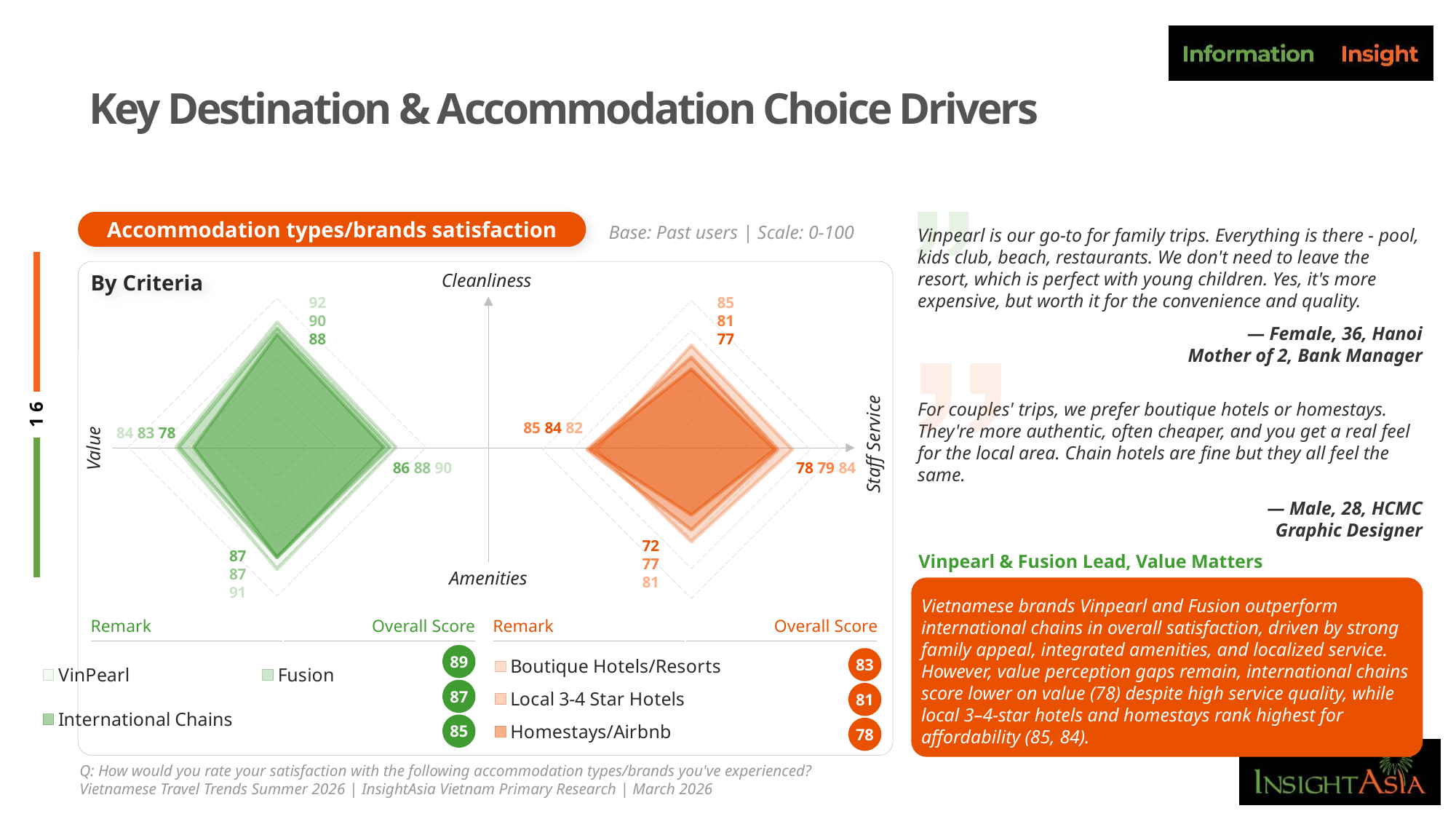
In the accommodation types chart (right, orange), what is the Overall Score for Homestays/Airbnb? 78 In the green brands chart, what is the Value score for International Chains? 78 How many criteria axes does each radar chart have? 4 What is the difference between the Overall Scores of VinPearl and International Chains? 4 What kind of chart is used in the 'By Criteria' panel to show satisfaction by criteria? Radar chart What is the title shown in the orange banner above the charts? Accommodation types/brands satisfaction In the orange accommodation types chart, which type has the highest Overall Score? Boutique Hotels/Resorts In the brands chart (left, green), what is the Overall Score for VinPearl? 89 In the green brands chart, what is the highest Cleanliness score shown? 92 Which has the higher Overall Score: Fusion or Local 3-4 Star Hotels? Fusion How many series does the legend of the green brands chart list? 3 In the orange accommodation types chart, what is the lowest Amenities score shown? 72